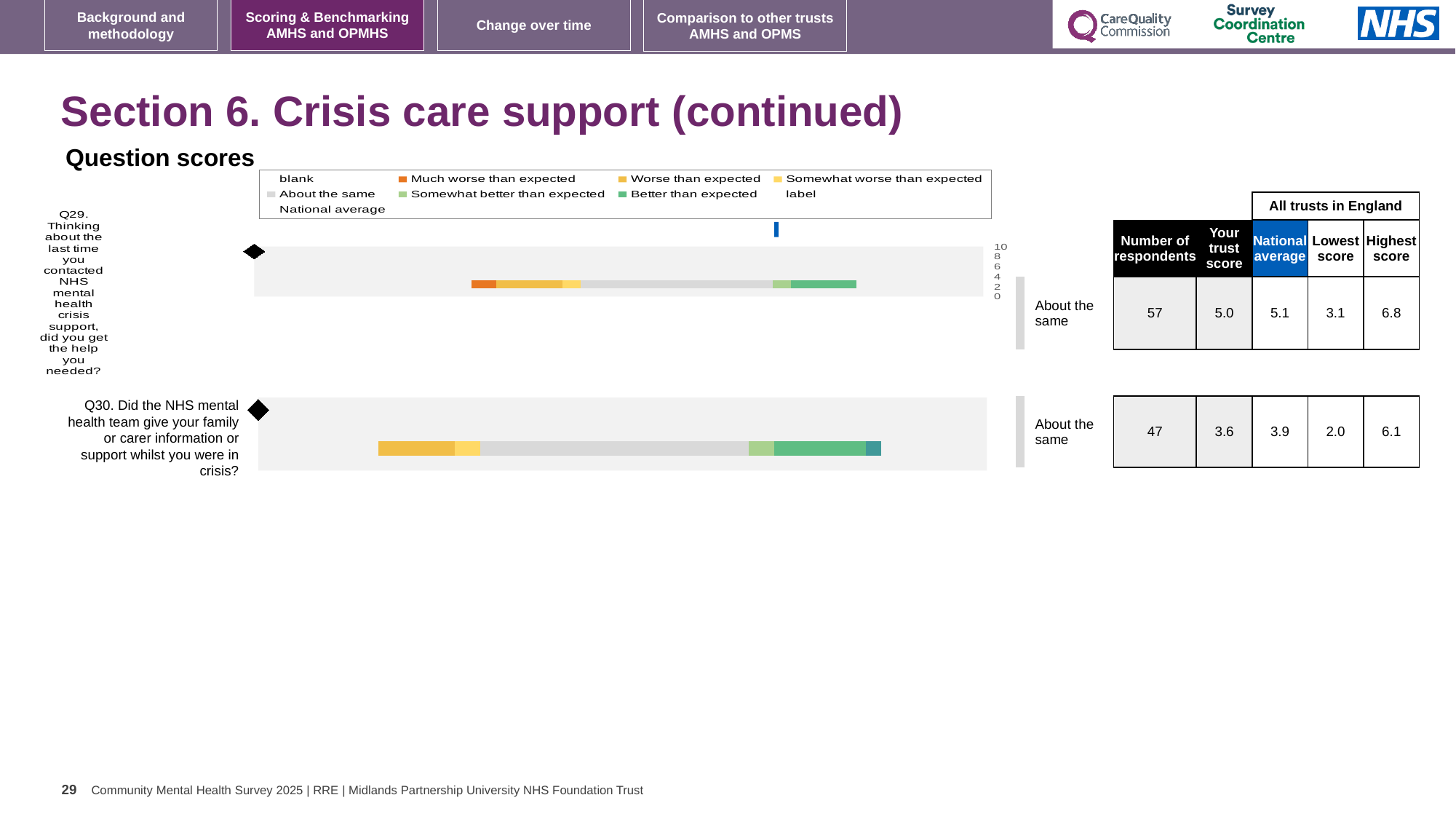
What is the lowest score across all trusts in England for Q30? 2.0 What is the difference between the national average and the trust score for Q29? 0.1 What is the difference between the highest and lowest score for Q30? 4.1 What kind of chart is used to show the question scores for Q29 and Q30? bar chart What is the highest score across all trusts in England for Q29? 6.8 How many questions are plotted on the slide? 2 What is the national average for Q30 shown in the table next to the chart? 3.9 Which legend entry is shown in orange? Much worse than expected Which question had more respondents, Q29 or Q30? Q29 How many respondents answered Q30? 47 What is the trust score for Q29 shown in the table next to the chart? 5.0 What benchmark category is shown for Q30? About the same